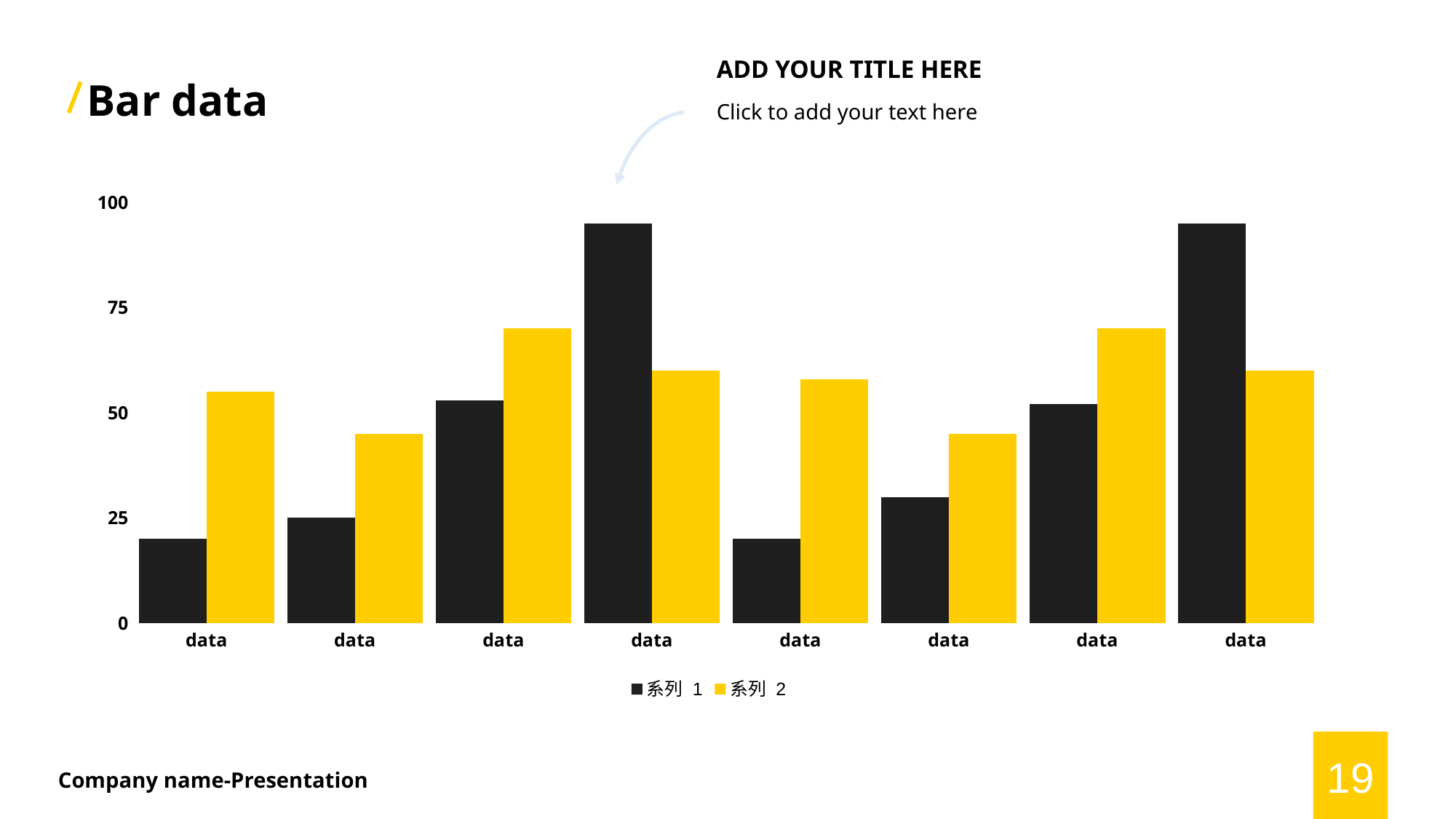
Is the 系列 2 value for the sixth category from the left greater or less than 50? less In the fourth category from the left, which series has the larger value, 系列 1 or 系列 2? 系列 1 Is the 系列 1 value for the fourth category from the left greater or less than 75? greater Is the 系列 1 value for the first category from the left greater or less than 25? less What are the two legend entries of the chart? 系列 1 and 系列 2 In the first category from the left, which series has the larger value, 系列 1 or 系列 2? 系列 2 What colour are the bars for 系列 2? yellow What kind of chart is shown on the slide? bar chart How many series does the legend list? 2 How many categories are plotted along the x axis? 8